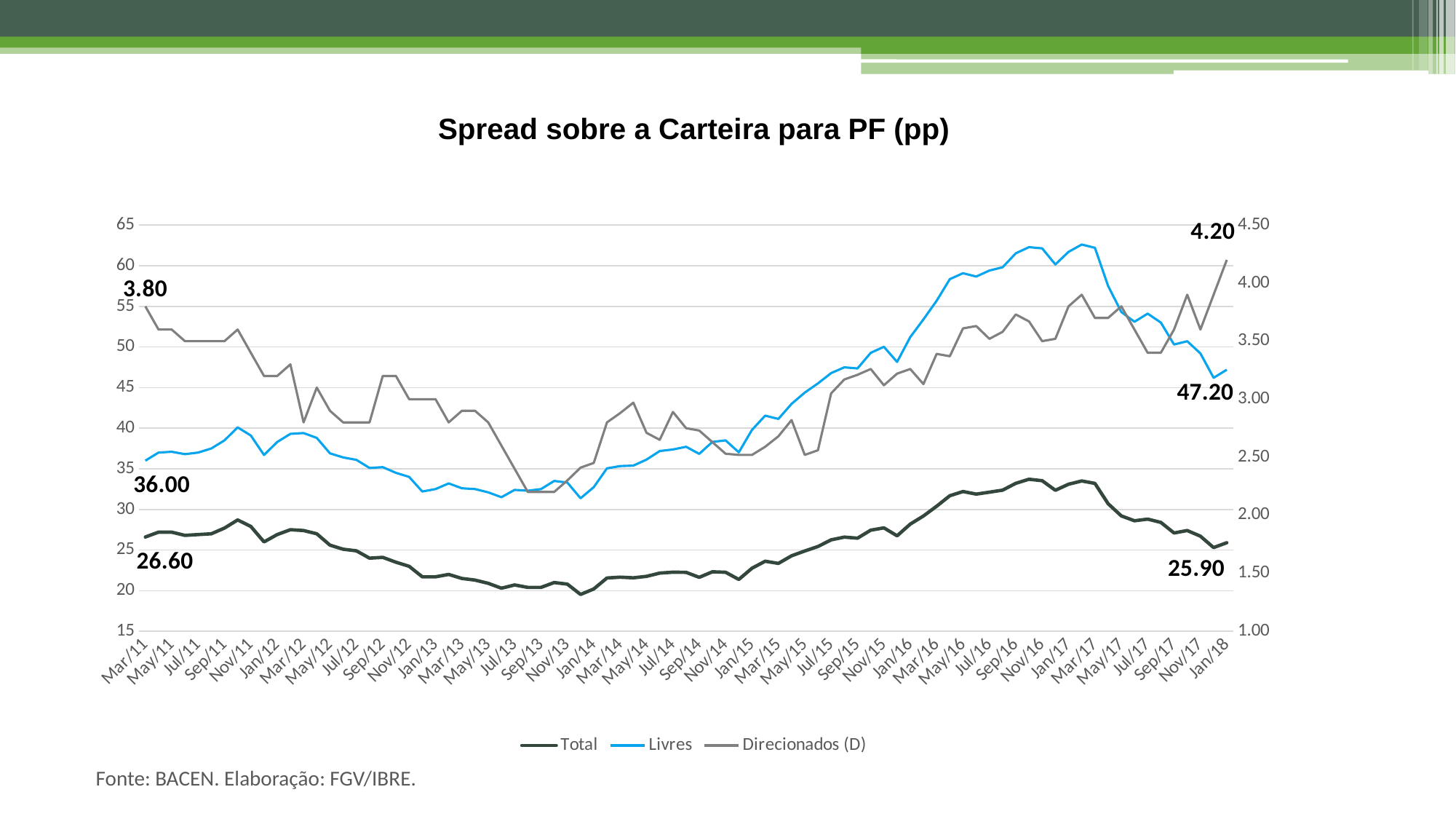
What is the value of the Livres series at Jan/18? 47.20 What kind of chart is shown on the slide? Line chart What is the value of the Livres series at Mar/11? 36.00 What is the difference between the Total value at Mar/11 (26.60) and at Jan/18 (25.90)? 0.70 How many series does the legend list? 3 By how much did the Livres series increase from Mar/11 (36.00) to Jan/18 (47.20)? 11.20 What is the value of the Direcionados (D) series at Mar/11? 3.80 What is the value of the Direcionados (D) series at Jan/18? 4.20 Is the peak value of the Livres series around Mar/17 greater or less than 60? greater What is the value of the Total series at Mar/11? 26.60 What is the title of the chart? Spread sobre a Carteira para PF (pp) Is the Total value higher at Mar/11 or at Jan/18? Mar/11